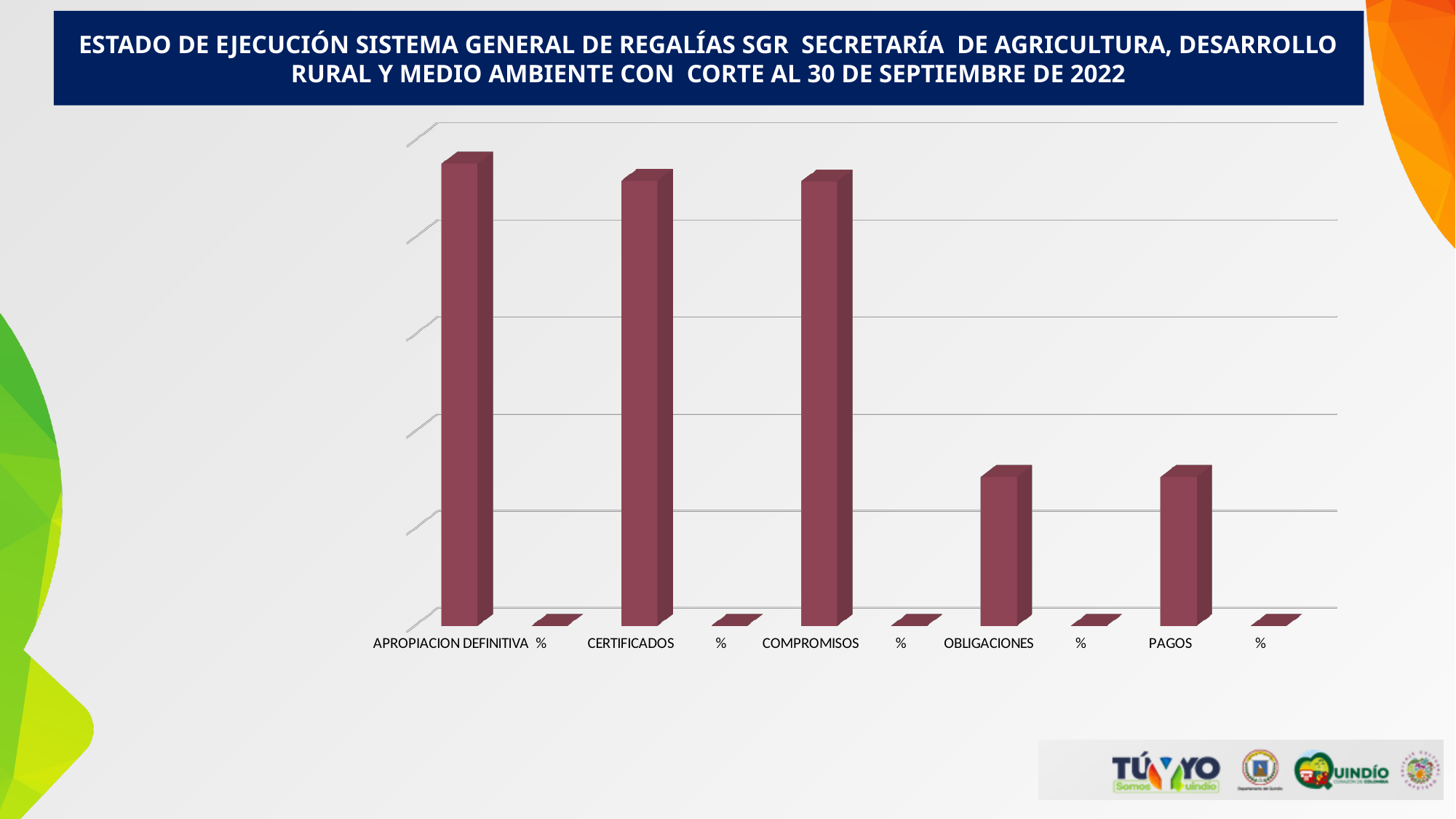
What colour are the bars in the chart? dark red What kind of chart is shown on the slide? bar chart How many categories are shown along the x axis of the chart? 10 Which is larger, the bar for CERTIFICADOS or the bar for OBLIGACIONES? CERTIFICADOS Which is larger, the bar for COMPROMISOS or the bar for PAGOS? COMPROMISOS Which is smaller, the bar for PAGOS or the bar for APROPIACION DEFINITIVA? PAGOS What is the cut-off date mentioned in the slide title? 30 de septiembre de 2022 Which category has the tallest bar in the chart? APROPIACION DEFINITIVA